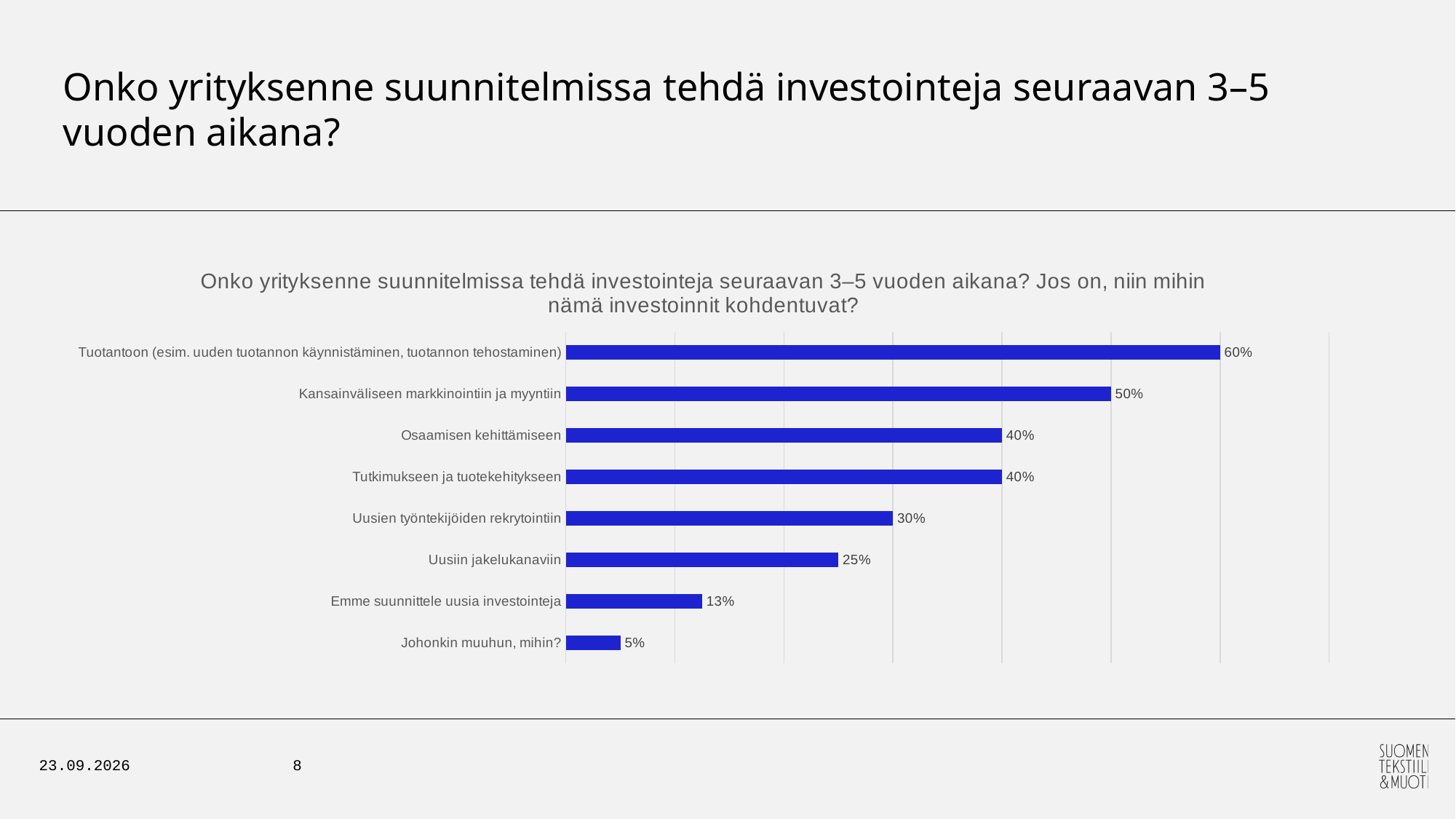
What is the value for "Emme suunnittele uusia investointeja"? 13% Which is larger, the value for "Uusien työntekijöiden rekrytointiin" or the value for "Uusiin jakelukanaviin"? Uusien työntekijöiden rekrytointiin Which category has the highest value? Tuotantoon (esim. uuden tuotannon käynnistäminen, tuotannon tehostaminen) What kind of chart is shown on the slide? Bar chart What is the difference between the values for "Uusien työntekijöiden rekrytointiin" and "Johonkin muuhun, mihin?"? 25% What is the difference between the values for "Tuotantoon (esim. uuden tuotannon käynnistäminen, tuotannon tehostaminen)" and "Kansainväliseen markkinointiin ja myyntiin"? 10% What is the value for "Uusiin jakelukanaviin"? 25% What is the value for "Tuotantoon (esim. uuden tuotannon käynnistäminen, tuotannon tehostaminen)"? 60% What is the title of the chart? Onko yrityksenne suunnitelmissa tehdä investointeja seuraavan 3–5 vuoden aikana? Jos on, niin mihin nämä investoinnit kohdentuvat? How many categories are shown in the chart? 8 What is the value for "Kansainväliseen markkinointiin ja myyntiin"? 50% Which category has the lowest value? Johonkin muuhun, mihin?